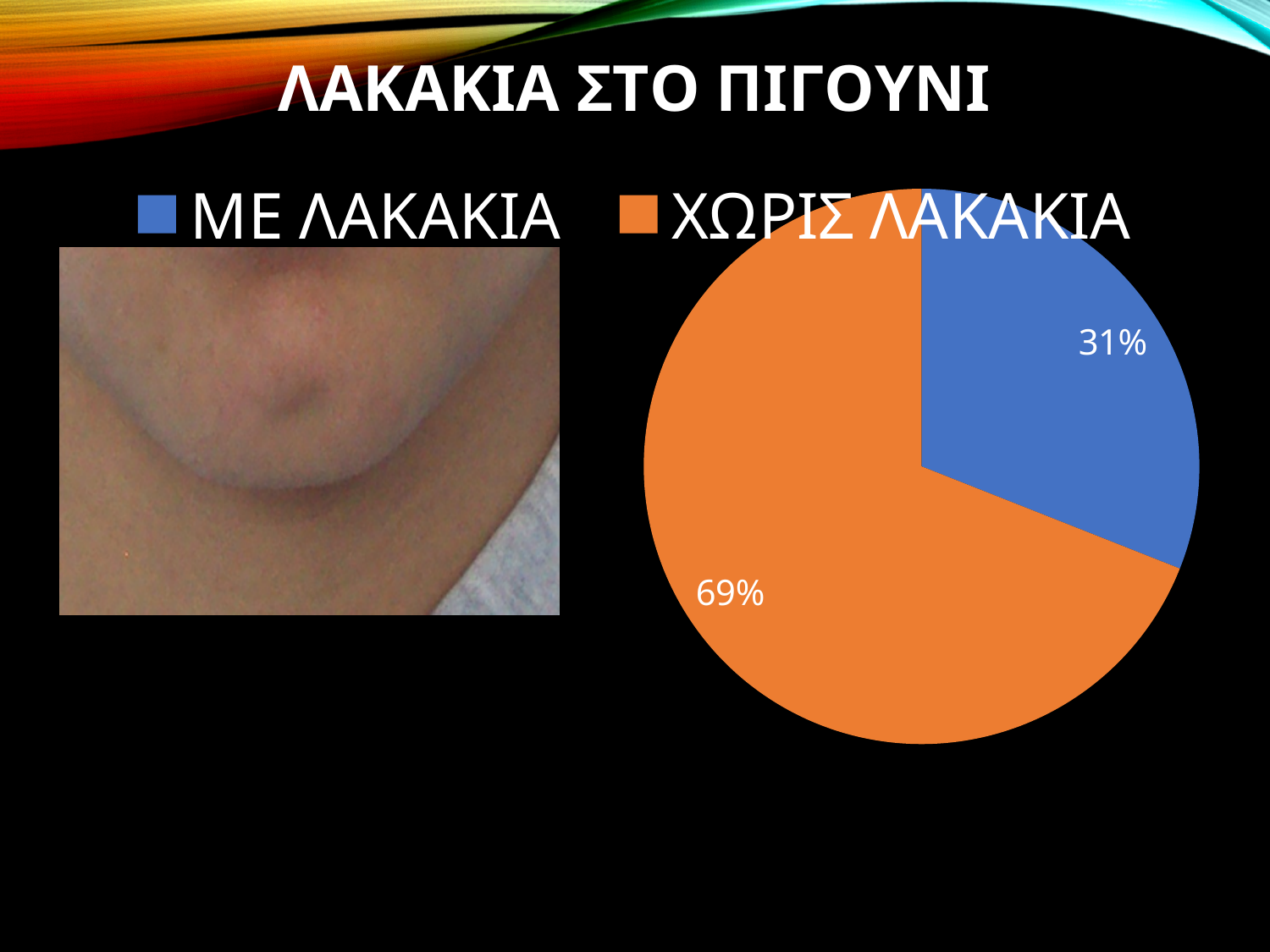
How many entries does the legend list? 2 What is the title of the slide containing the pie chart? ΛΑΚΑΚΙΑ ΣΤΟ ΠΙΓΟΥΝΙ What share of the pie does ΜΕ ΛΑΚΑΚΙΑ represent? 31% How many categories does the pie chart show? 2 Which category has the largest slice of the pie? ΧΩΡΙΣ ΛΑΚΑΚΙΑ What colour is the slice for ΧΩΡΙΣ ΛΑΚΑΚΙΑ? Orange What colour is the slice for ΜΕ ΛΑΚΑΚΙΑ? Blue What share of the pie does ΧΩΡΙΣ ΛΑΚΑΚΙΑ represent? 69% What kind of chart is shown on the slide? Pie chart Which category has the smallest slice of the pie? ΜΕ ΛΑΚΑΚΙΑ Which is larger, the share for ΜΕ ΛΑΚΑΚΙΑ or the share for ΧΩΡΙΣ ΛΑΚΑΚΙΑ? ΧΩΡΙΣ ΛΑΚΑΚΙΑ What is the difference in percentage points between ΧΩΡΙΣ ΛΑΚΑΚΙΑ and ΜΕ ΛΑΚΑΚΙΑ? 38